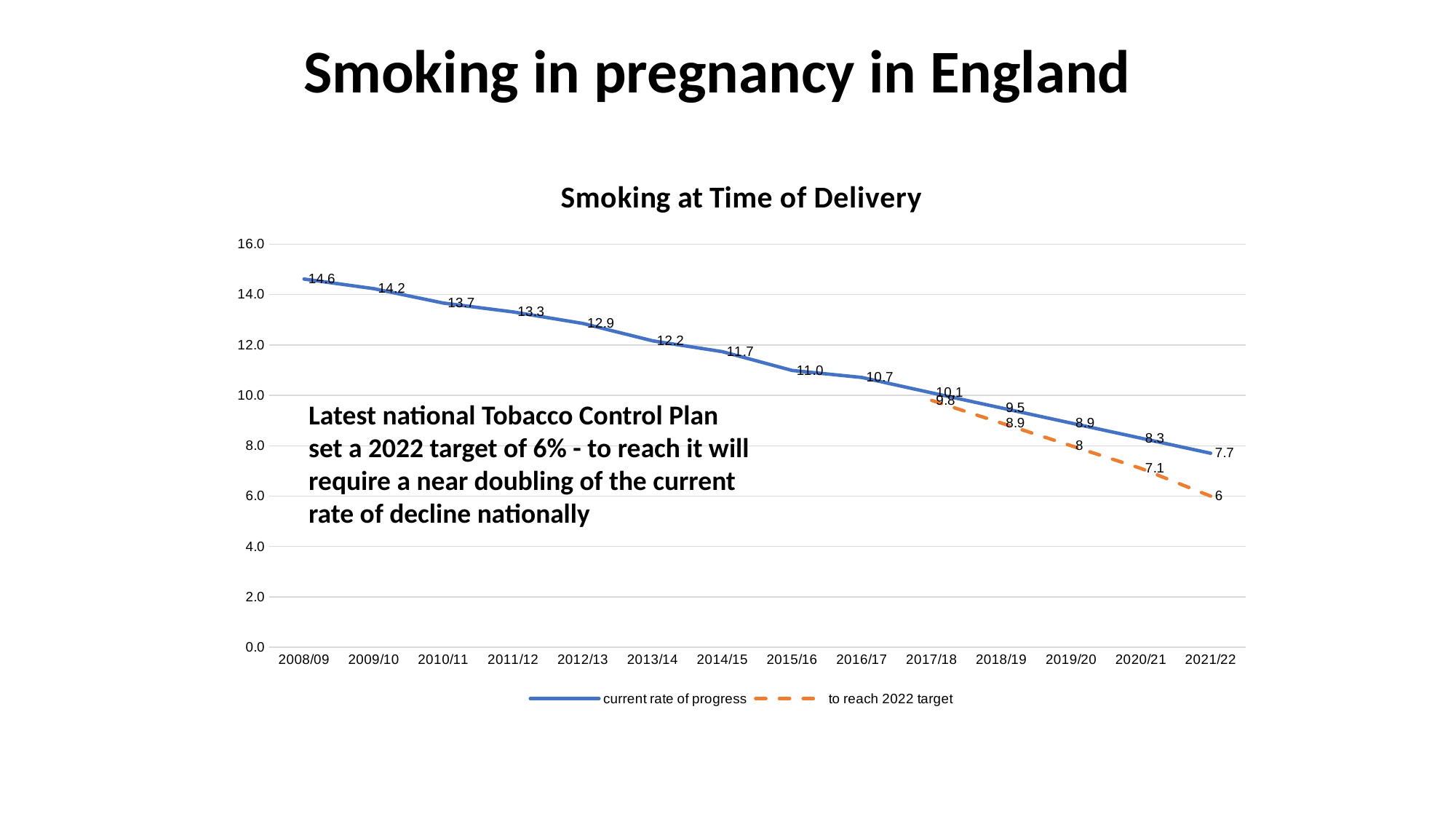
What is the title of the chart? Smoking at Time of Delivery In which year is the 'current rate of progress' value highest? 2008/09 What is the value for 'to reach 2022 target' in 2019/20? 8 What is the difference between the 'current rate of progress' and 'to reach 2022 target' values in 2021/22? 1.7 In which year is the 'current rate of progress' value lowest? 2021/22 What type of chart is shown on the slide? line chart How many series does the legend list? 2 Does the 'current rate of progress' line rise or fall from 2008/09 to 2021/22? fall What is the value for 'to reach 2022 target' in 2021/22? 6 What is the value for 'current rate of progress' in 2008/09? 14.6 How many years are shown on the x axis? 14 What is the value for 'current rate of progress' in 2015/16? 11.0